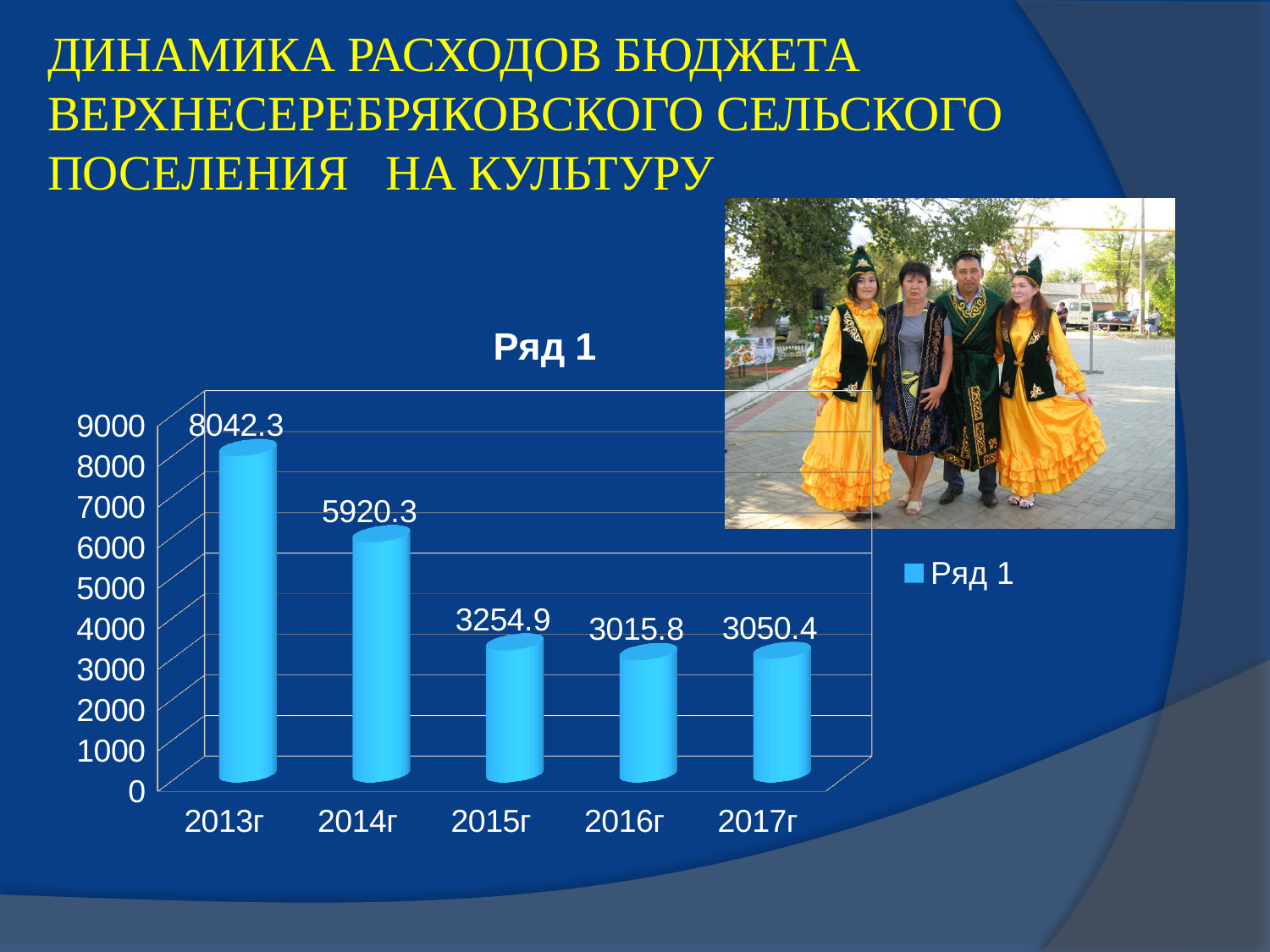
Which year has the lowest value? 2016г Is the value for 2014г greater or less than 5000? greater Which year has the highest value? 2013г What is the difference between the values for 2015г and 2016г? 239.1 What is the name of the series shown in the legend? Ряд 1 What is the value for 2015г? 3254.9 What is the difference between the values for 2013г and 2014г? 2122 Which is larger, the value for 2014г or the value for 2015г? 2014г What is the value for 2013г? 8042.3 What is the value for 2017г? 3050.4 How many years are shown on the x axis? 5 What kind of chart is shown on the slide? bar chart